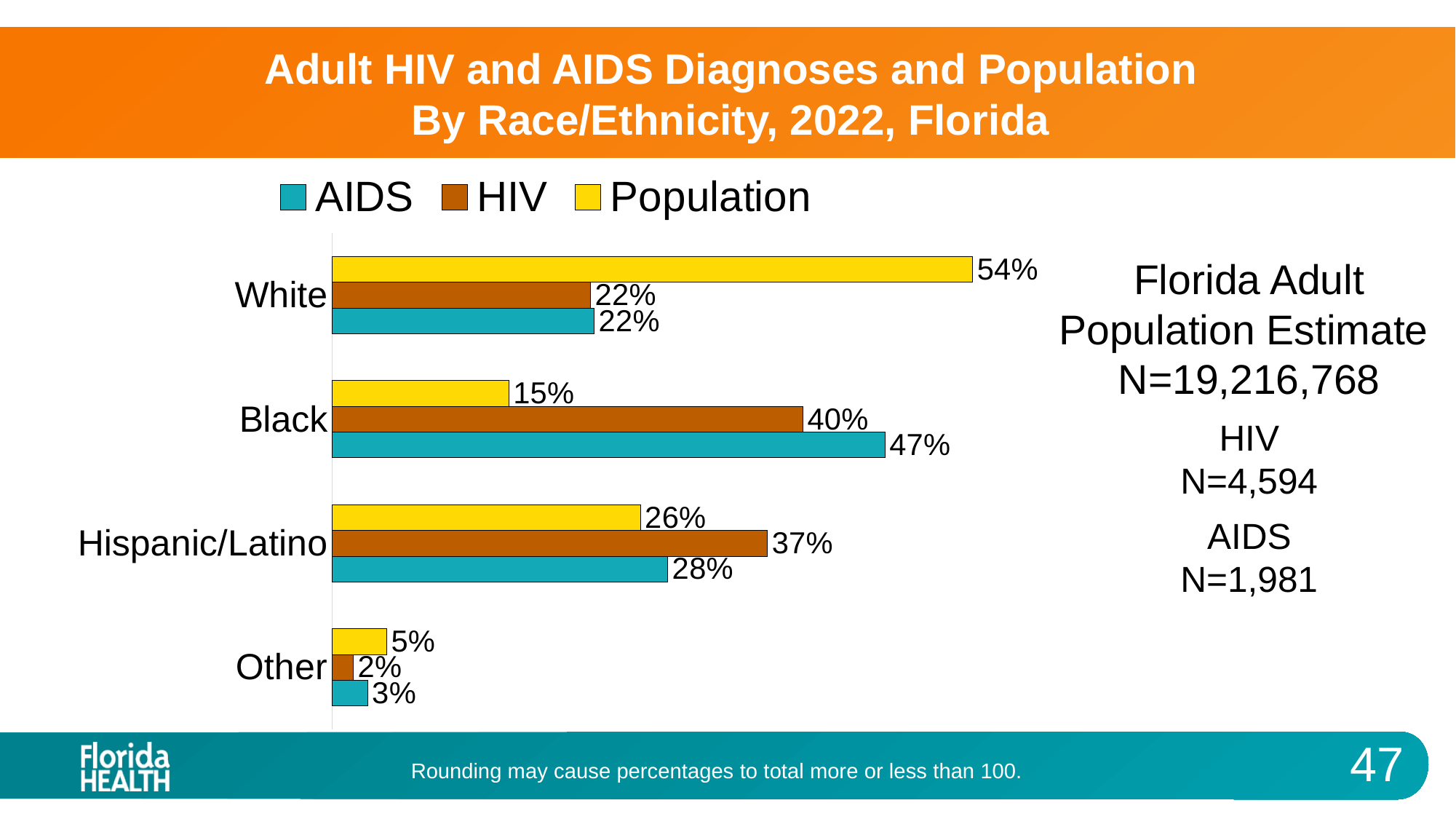
How many race/ethnicity categories are shown on the chart? 4 What kind of chart is shown on the slide? Bar chart Which is larger for Hispanic/Latino, the HIV value or the AIDS value? HIV Which race/ethnicity has the highest HIV value? Black What is the HIV value for Other? 2% What is the AIDS value for Black? 47% What is the Population value for White? 54% What is the HIV value for Hispanic/Latino? 37% What is the difference between the Population value and the HIV value for White? 32% What colour represents the Population series in the legend? Yellow How many series does the legend list? 3 Which race/ethnicity has the lowest Population value? Other